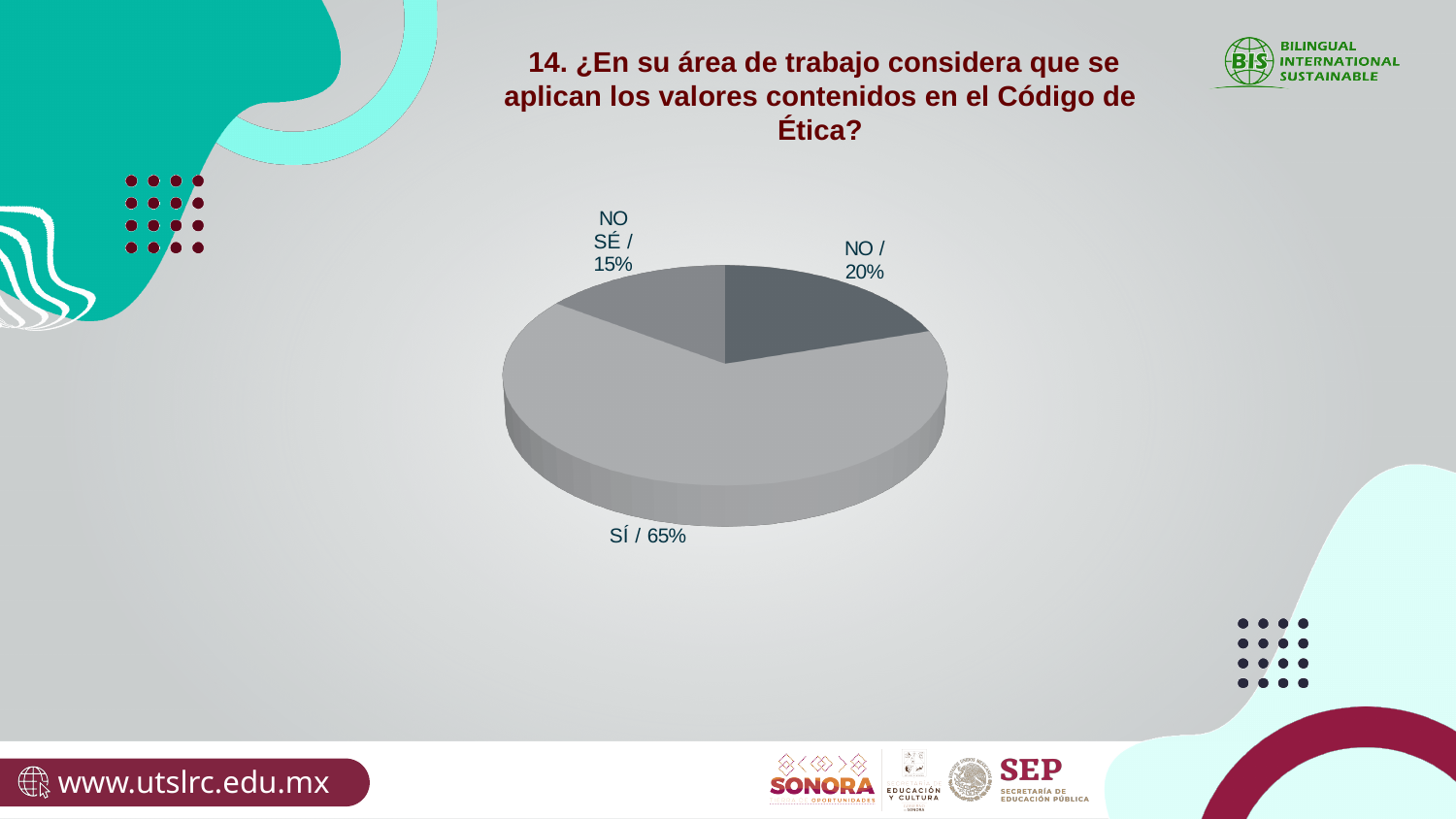
Which response has the largest share of the pie? SÍ Which response has the smallest share of the pie? NO SÉ What is the title of the chart? 14. ¿En su área de trabajo considera que se aplican los valores contenidos en el Código de Ética? What is the combined share of the "NO" and "NO SÉ" slices? 35% What percentage of responses are "SÍ"? 65% How many slices does the pie chart have? 3 Which is larger, the "NO" slice or the "NO SÉ" slice? NO What kind of chart is shown on the slide? pie chart What is the difference in percentage points between the "NO" and "NO SÉ" slices? 5 What percentage of responses are "NO"? 20% What percentage of responses are "NO SÉ"? 15% What is the difference in percentage points between the "SÍ" and "NO" slices? 45